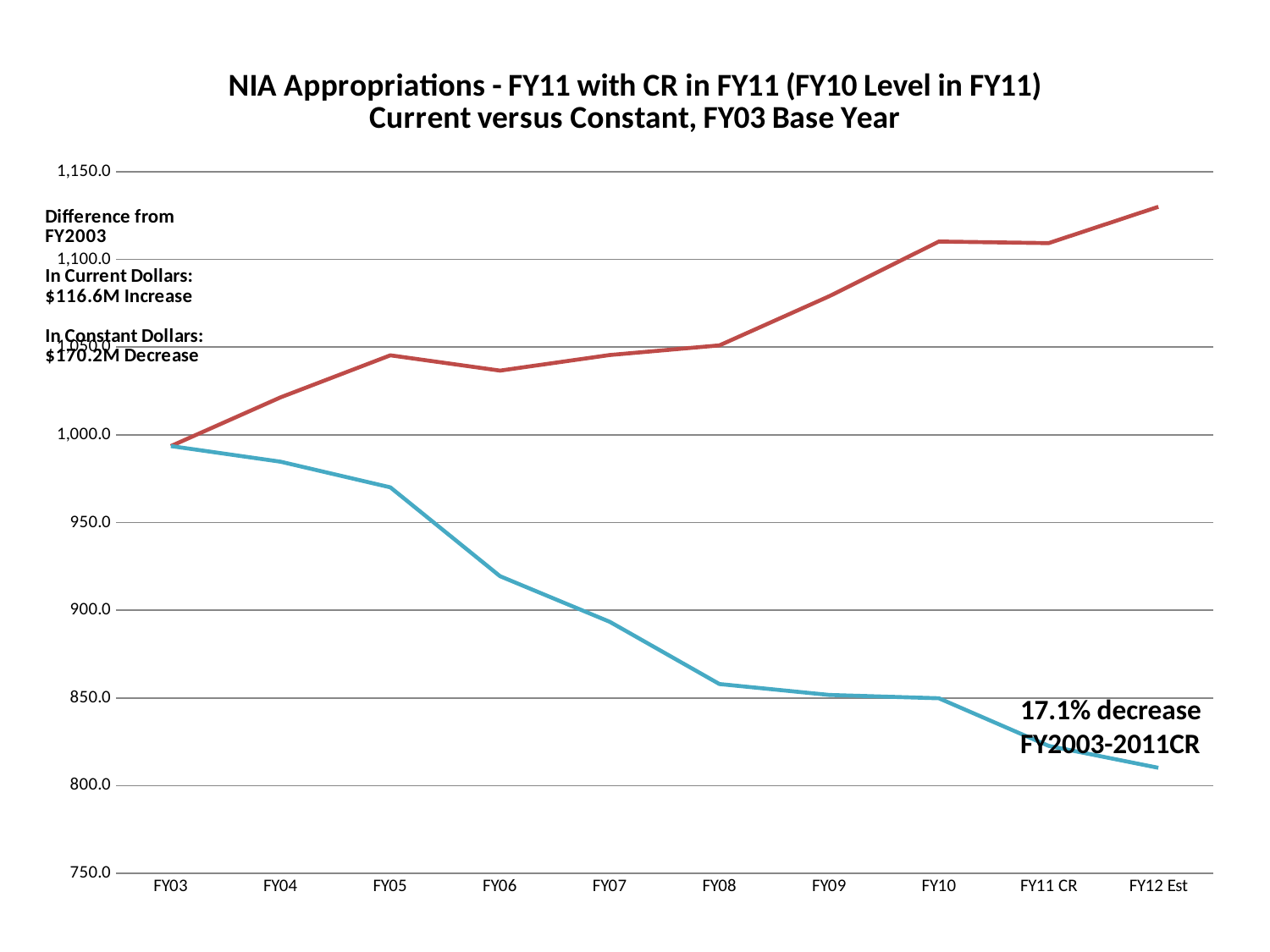
Is the value of the blue line at FY12 Est greater or less than 850? less At which fiscal year does the blue line reach its lowest value? FY12 Est At FY10, which line has the larger value, the red line or the blue line? red line Is the value of the red line at FY12 Est greater or less than 1,100? greater At which fiscal year is the blue line at its highest value? FY03 What kind of chart is shown on the slide? line chart Does the blue line rise or fall from FY03 to FY12 Est? fall Does the red line rise or fall from FY03 to FY12 Est? rise Is the value of the blue line at FY06 greater or less than 950? less According to the annotation on the chart, what is the percentage decrease from FY2003 to 2011CR? 17.1% decrease How many fiscal-year points are plotted along the x axis? 10 At which fiscal year does the red line reach its highest value? FY12 Est